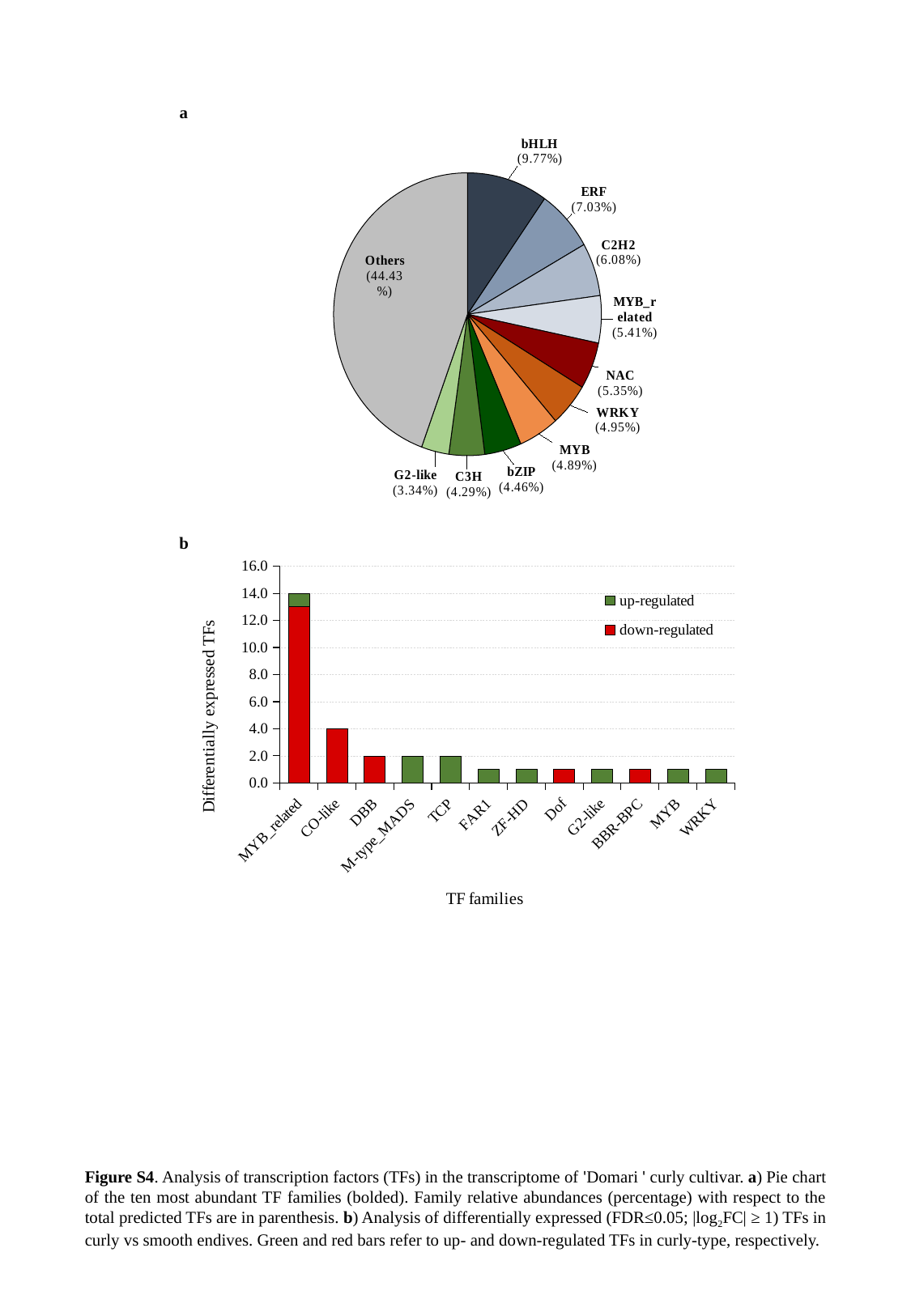
In the pie chart (a), which slice is the largest? Others In the pie chart (a), what is the difference in percentage points between ERF and C2H2? 0.95% In the pie chart (a), which has the larger share, NAC or WRKY? NAC In the pie chart (a), which of the labelled TF families has the smallest share? G2-like How many series does the legend of chart (b) list? 2 What kind of chart is chart (b)? bar chart In chart (b), is the value for FAR1 greater or less than 2.0? less How many slices does the pie chart (a) have? 11 In the pie chart (a), what percentage is shown for bHLH? 9.77% How many TF families are shown on the x axis of chart (b)? 12 In the pie chart (a), what percentage is shown for MYB_related? 5.41% In chart (b), which TF family has the tallest bar? MYB_related